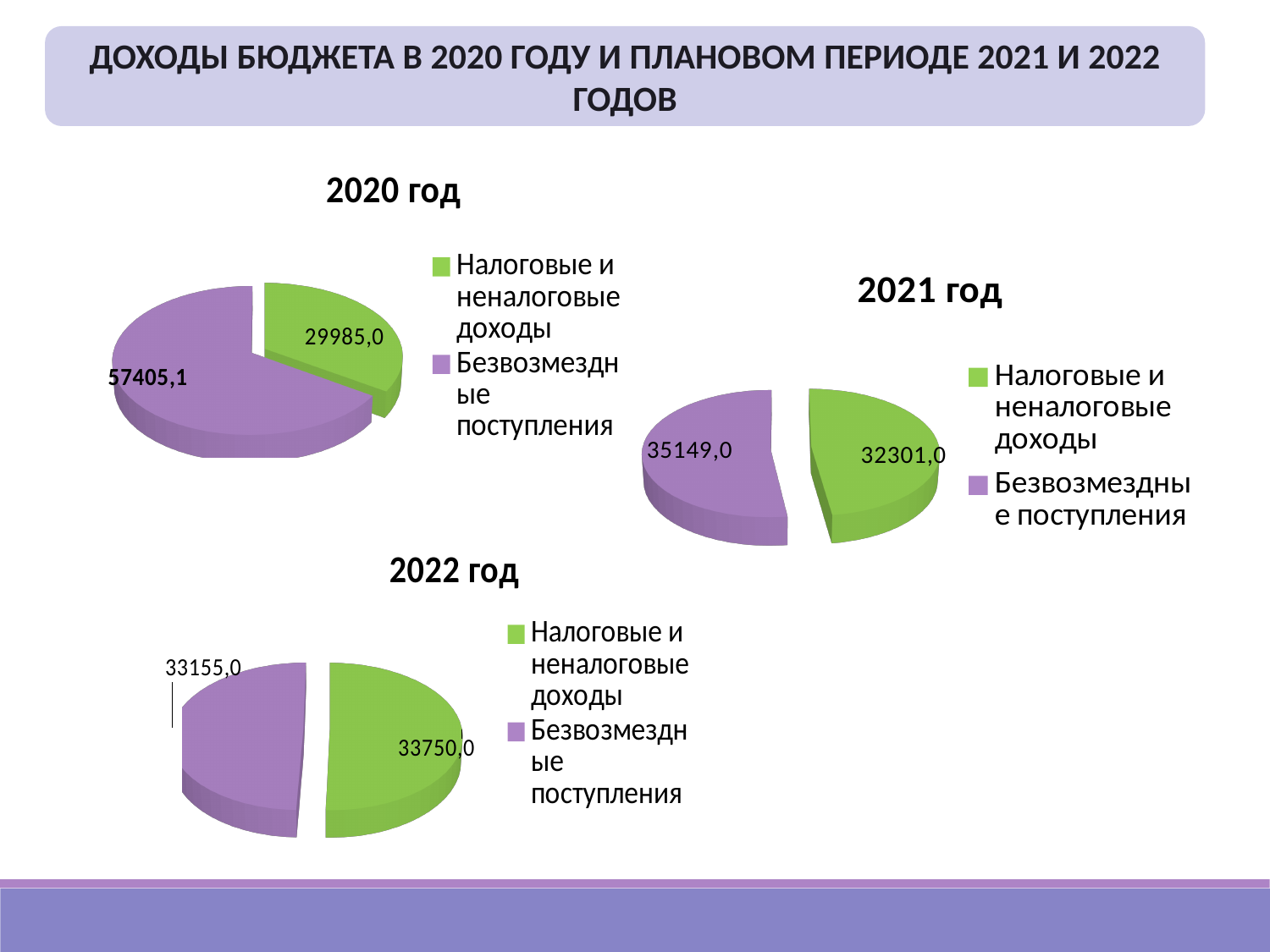
In the 2021 год chart, what is the difference between Безвозмездные поступления and Налоговые и неналоговые доходы? 2848,0 In the 2022 год chart, what is the difference between Налоговые и неналоговые доходы and Безвозмездные поступления? 595,0 How many charts are shown on the slide? 3 What kind of chart is the 2020 год chart? Pie chart In the 2020 год chart, what is the value for Налоговые и неналоговые доходы? 29985,0 In the 2022 год chart, what is the value for Налоговые и неналоговые доходы? 33750,0 In the 2021 год chart, what is the value for Безвозмездные поступления? 35149,0 In the 2020 год chart, what is the value for Безвозмездные поступления? 57405,1 In the 2022 год chart, which category has the smallest slice? Безвозмездные поступления How many series does the legend of the 2021 год chart list? 2 In the 2021 год chart, which is larger: Налоговые и неналоговые доходы or Безвозмездные поступления? Безвозмездные поступления In the 2020 год chart, which category has the largest slice? Безвозмездные поступления